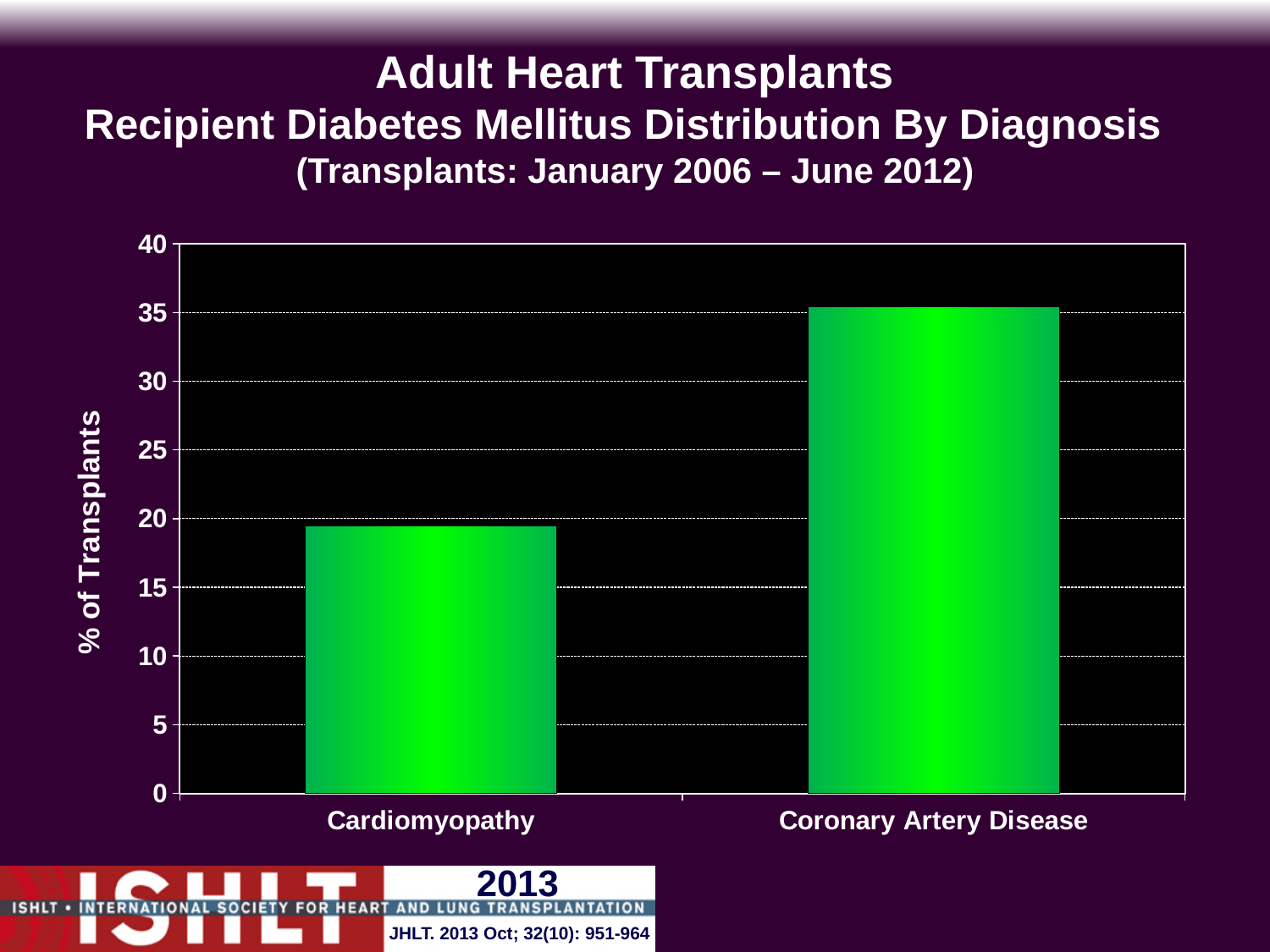
Is the value for Coronary Artery Disease greater or less than 40? less What time period of transplants does the chart title cover? January 2006 – June 2012 What kind of chart is shown on the slide? bar chart How many categories are plotted on the x axis? 2 Which category has the lowest % of transplants? Cardiomyopathy Is the value for Cardiomyopathy greater or less than 15? greater Which is larger, the value for Cardiomyopathy or the value for Coronary Artery Disease? Coronary Artery Disease What is the label of the y axis? % of Transplants Which category has the highest % of transplants? Coronary Artery Disease Is the value for Coronary Artery Disease greater or less than 35? greater